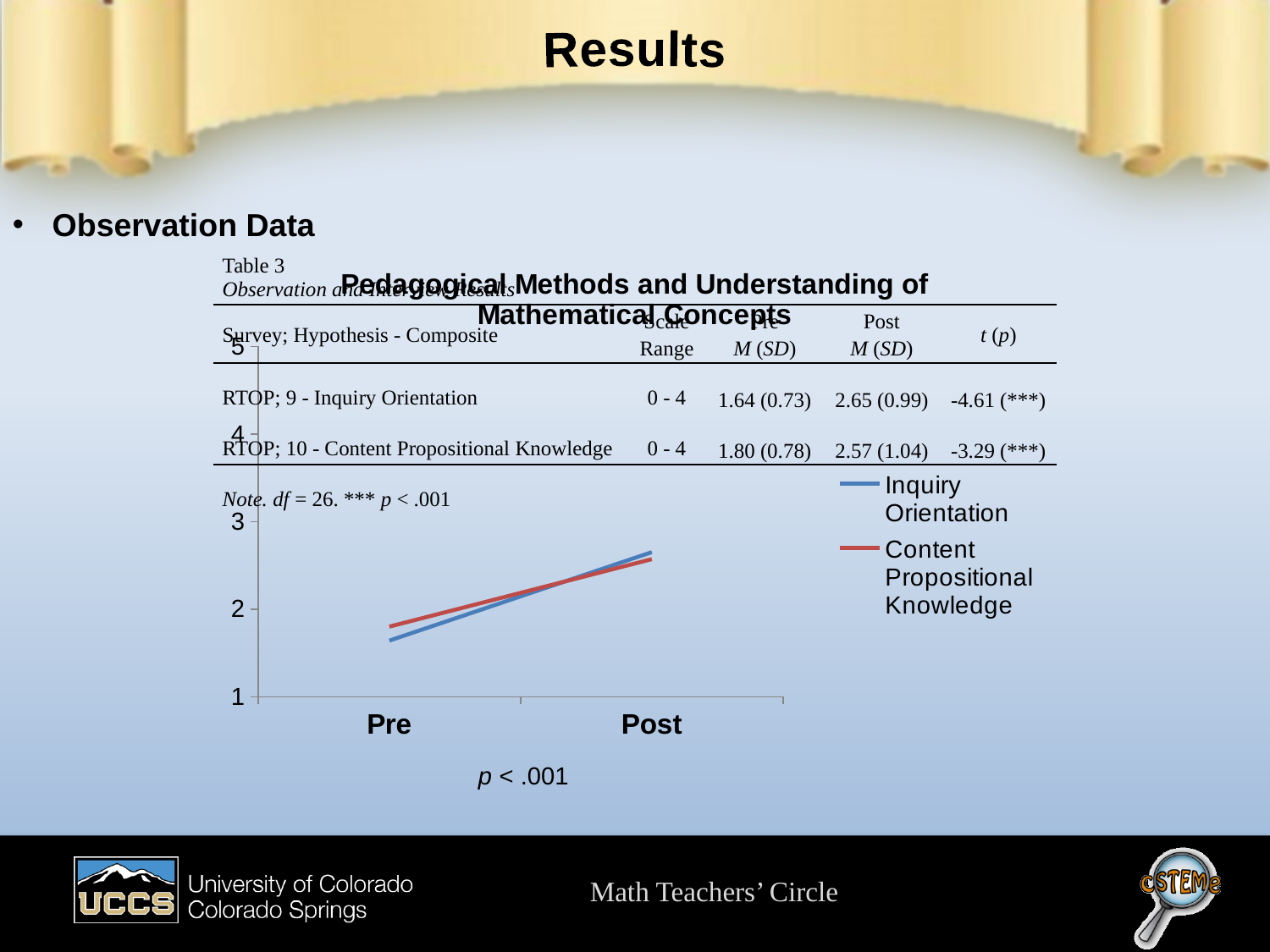
Does the Inquiry Orientation line rise or fall from Pre to Post? rise What kind of chart is shown on the slide? line chart At Pre, which series has the higher value, Inquiry Orientation or Content Propositional Knowledge? Content Propositional Knowledge Is the Post value for Inquiry Orientation greater or less than 2? greater How many categories are shown on the x axis of the chart? 2 Which colour is used for the Content Propositional Knowledge line in the chart? red Is the Post value for Content Propositional Knowledge greater or less than 3? less How many series does the chart legend list? 2 Is the Pre value for Inquiry Orientation greater or less than 2? less Does the Content Propositional Knowledge line rise or fall from Pre to Post? rise What is the title of the chart? Pedagogical Methods and Understanding of Mathematical Concepts